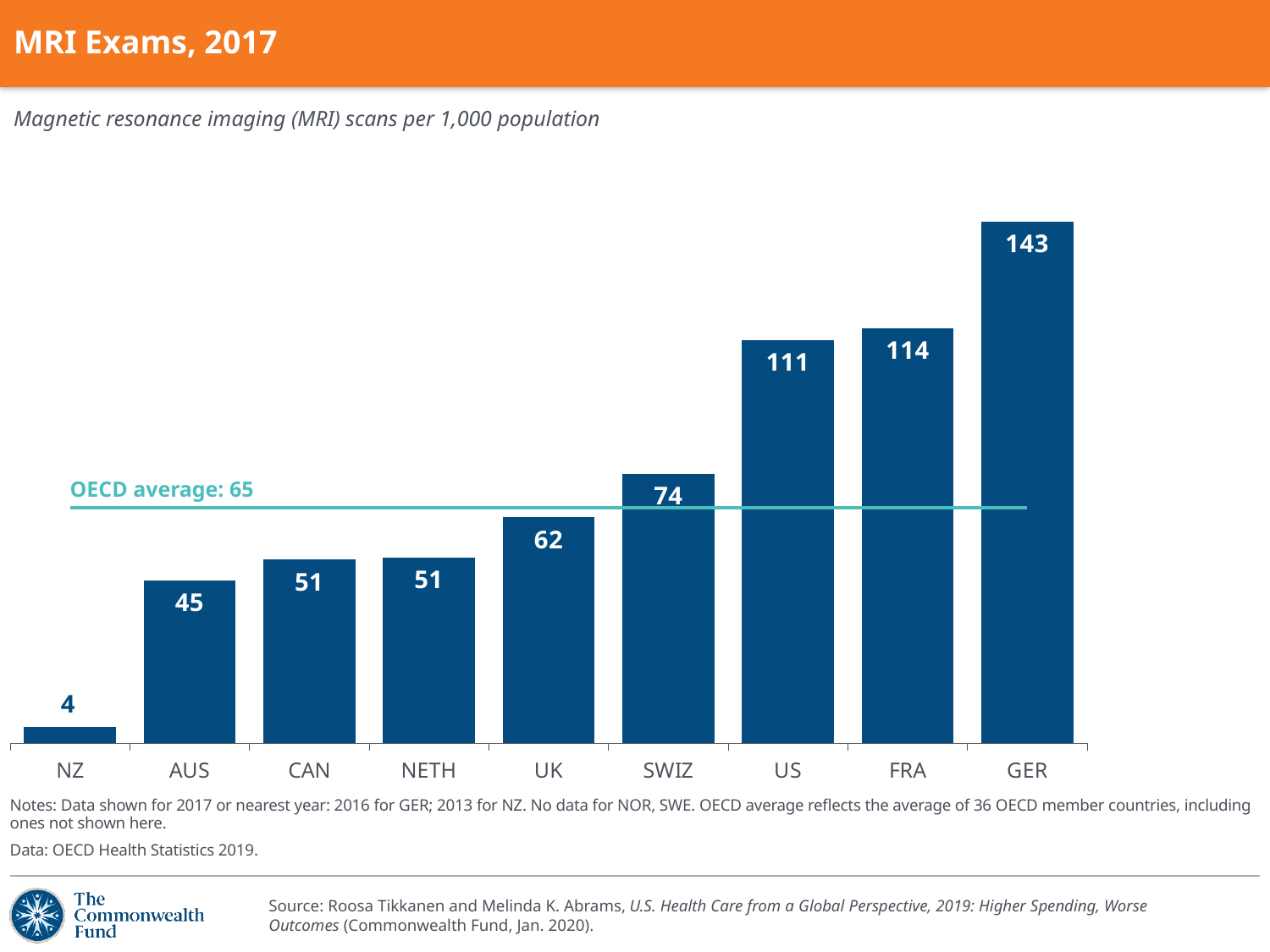
Which country has the lowest number of MRI scans per 1,000 population? NZ Do the values rise or fall from left to right along the x axis? Rise What is the value for the US? 111 What OECD average is marked by the horizontal line on the chart? 65 Which is larger, the value for SWIZ or the value for UK? SWIZ What is the value for NZ? 4 How many countries are shown in the chart? 9 Which country has the highest number of MRI scans per 1,000 population? GER What kind of chart is shown on the slide? Bar chart What is the difference between the values for FRA and UK? 52 What is the difference between the values for GER and the US? 32 What is the value for GER? 143